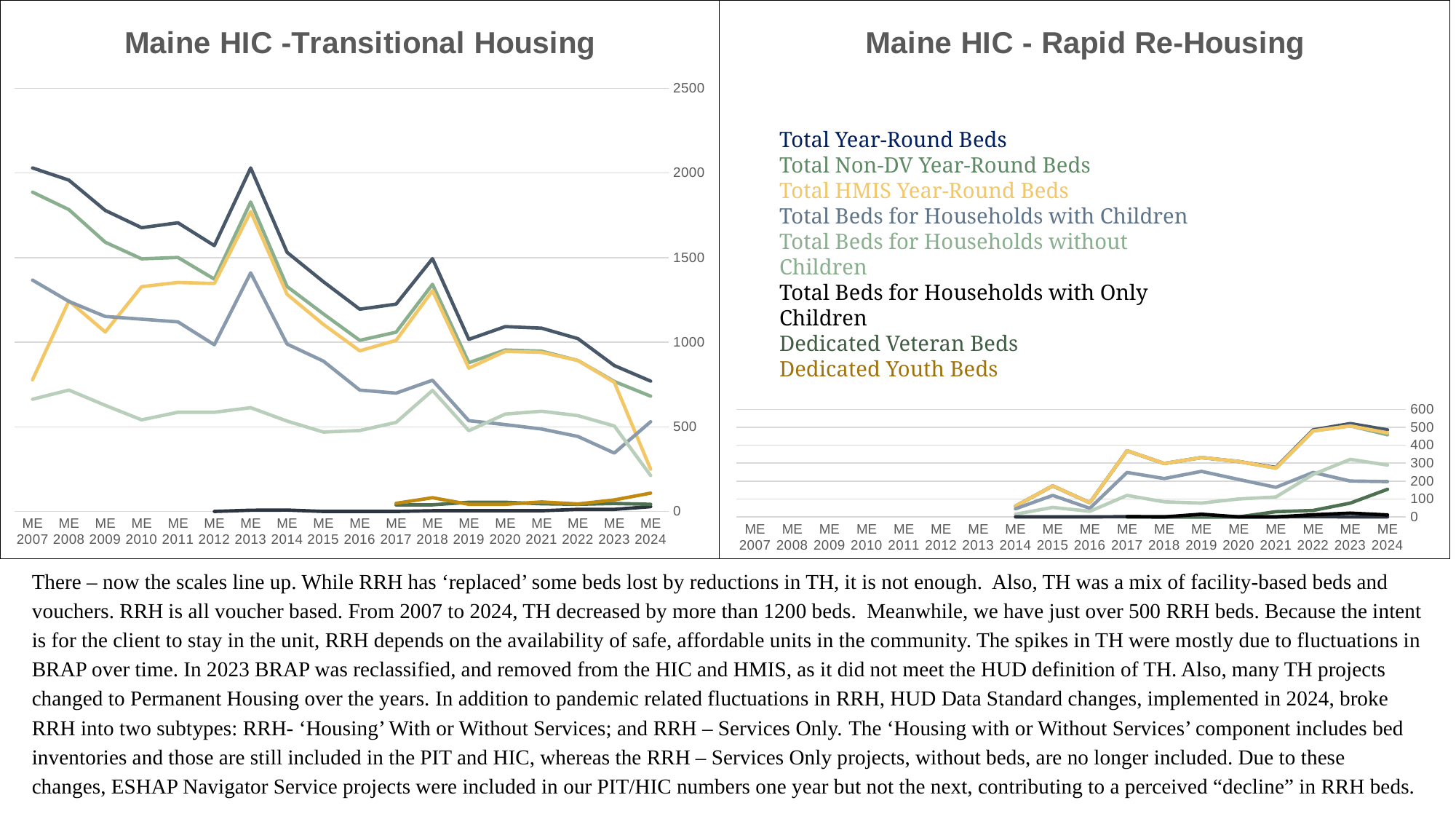
In the Maine HIC - Rapid Re-Housing chart, do Total Year-Round Beds rise or fall overall from ME 2014 to ME 2024? rise How many years are shown on the x axis of the Maine HIC - Transitional Housing chart? 18 What kind of chart is the Maine HIC - Transitional Housing chart? Line chart What is the title of the chart on the right side of the slide? Maine HIC - Rapid Re-Housing In the Maine HIC - Rapid Re-Housing chart, is the value for Total Year-Round Beds in ME 2024 greater or less than 400? greater In the Maine HIC - Transitional Housing chart, in which year is Total HMIS Year-Round Beds highest? ME 2013 In the Maine HIC - Transitional Housing chart, is the value for Total Beds for Households without Children in ME 2007 greater or less than 1000? less In the Maine HIC - Transitional Housing chart, do Total Year-Round Beds rise or fall overall from ME 2007 to ME 2024? fall In the Maine HIC - Transitional Housing chart, is Total Year-Round Beds larger in ME 2013 or ME 2018? ME 2013 In the Maine HIC - Transitional Housing chart, is the value for Total Year-Round Beds in ME 2024 greater or less than 1000? less How many series does the legend on the Maine HIC - Rapid Re-Housing chart list? 8 In which year do the plotted lines begin on the Maine HIC - Rapid Re-Housing chart? ME 2014